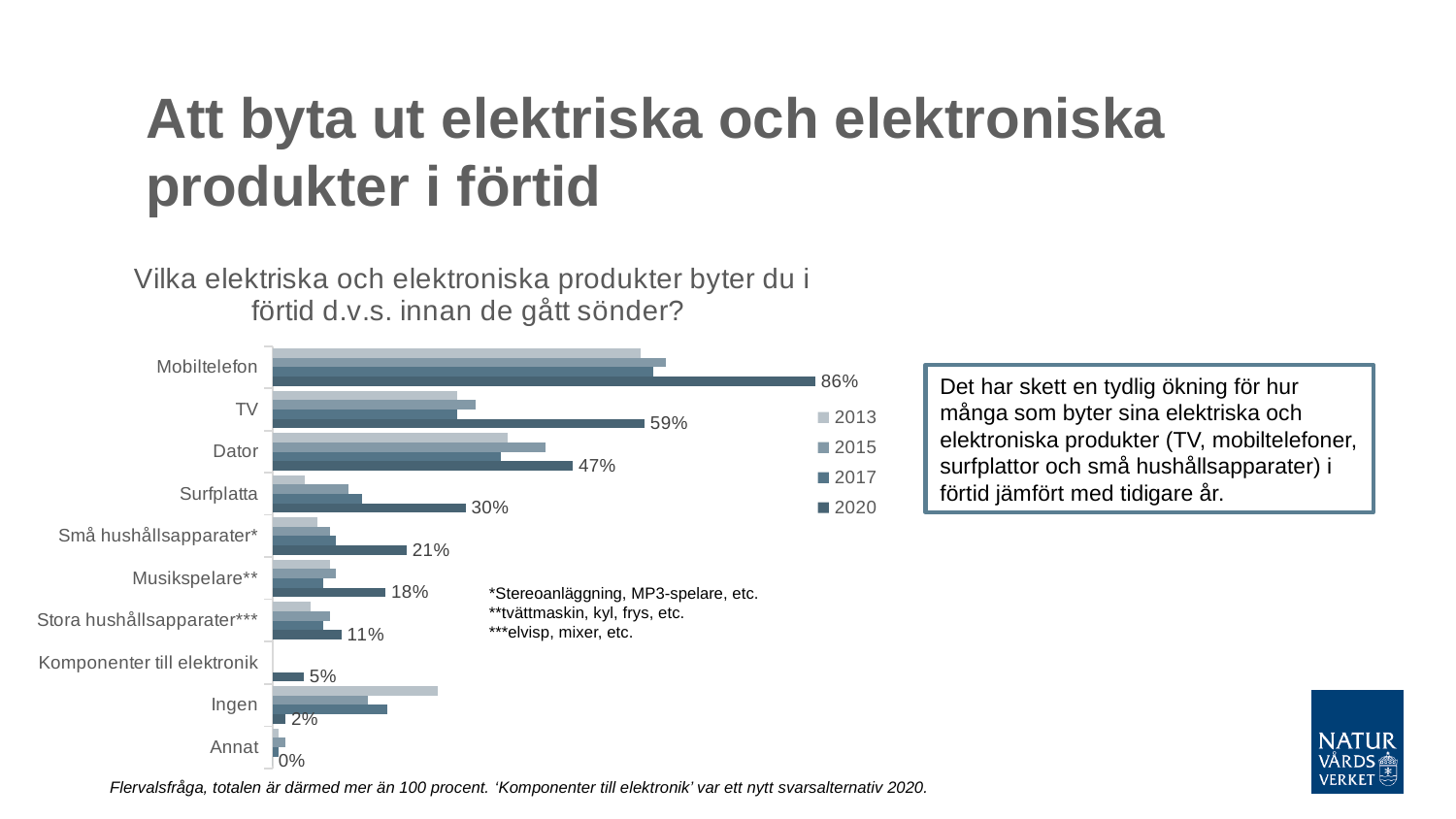
Which has a larger 2020 value, Dator or Små hushållsapparater*? Dator How many product categories are shown on the chart? 10 What is the difference between the 2020 values for Mobiltelefon and TV? 27% What is the 2020 value for Surfplatta? 30% What is the 2020 value for Stora hushållsapparater***? 11% What is the 2020 value for Mobiltelefon? 86% What is the 2020 value for TV? 59% Which category has the lowest 2020 value? Annat Which category has the highest 2020 value? Mobiltelefon How many series does the legend list? 4 Which years are listed in the chart legend? 2013, 2015, 2017, 2020 What type of chart is shown on the slide? bar chart